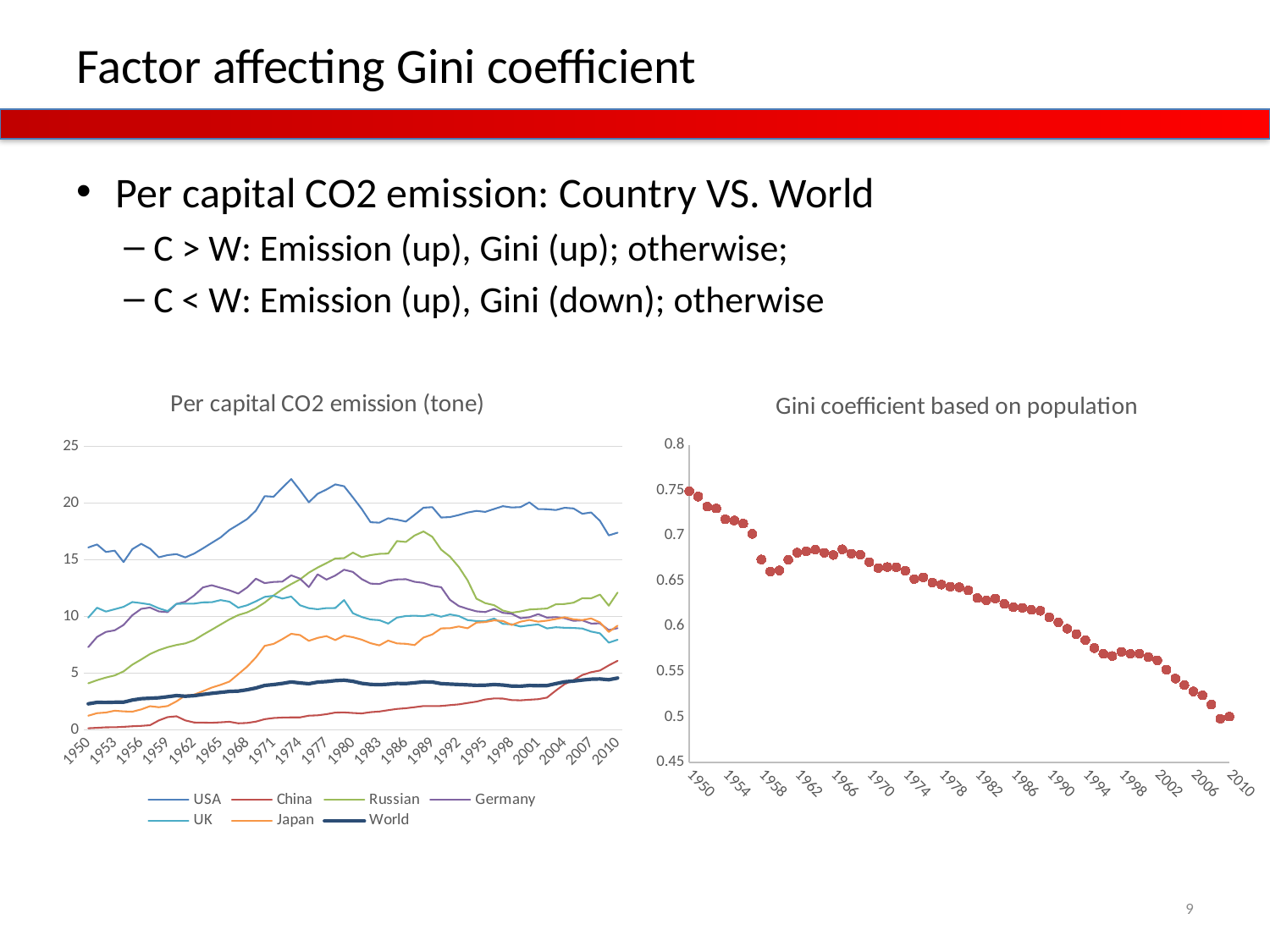
In the 'Per capital CO2 emission (tone)' chart, which series has the lowest value in 1950? China In the 'Gini coefficient based on population' chart, is the value for 2010 greater or less than 0.55? less In the 'Per capital CO2 emission (tone)' chart, which is larger in 1950, UK or Japan? UK In the 'Gini coefficient based on population' chart, is the value for 1950 greater or less than 0.7? greater In the 'Per capital CO2 emission (tone)' chart, which is larger in 1989, Russian or Germany? Russian In the 'Per capital CO2 emission (tone)' chart, is the value for Japan in 1950 greater or less than 5? less What type of chart is the 'Per capital CO2 emission (tone)' chart? line chart In the 'Per capital CO2 emission (tone)' chart, which series has the highest values across the whole period? USA How many series does the legend of the 'Per capital CO2 emission (tone)' chart list? 7 In the 'Gini coefficient based on population' chart, do the values generally rise or fall from 1950 to 2010? fall